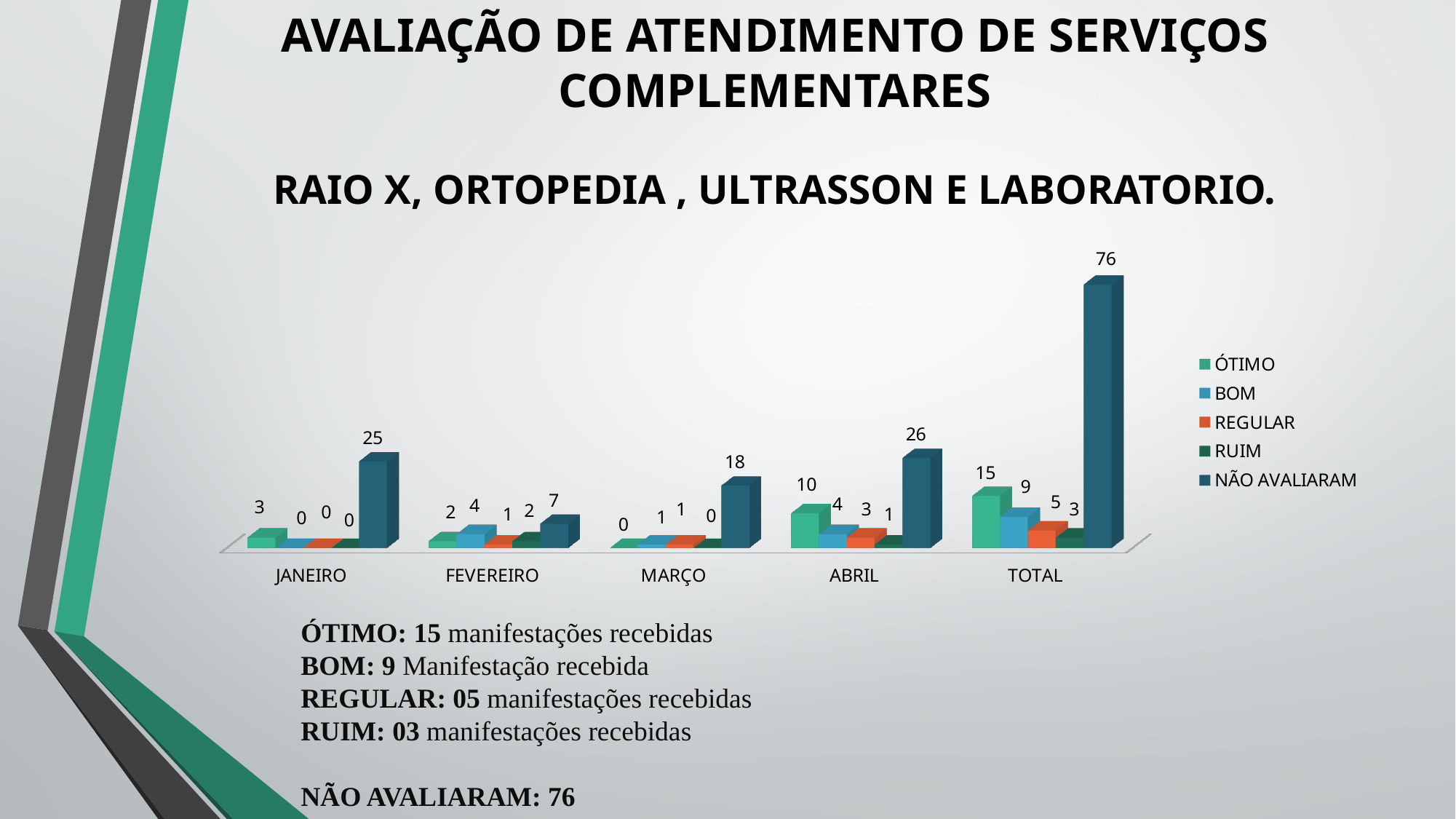
How many categories are shown along the x axis of the chart? 5 Which month has the highest NÃO AVALIARAM value (excluding TOTAL)? ABRIL What is the value of ÓTIMO for ABRIL? 10 How many series does the chart legend list? 5 Which series is shown in orange in the chart legend? REGULAR What is the value of BOM for FEVEREIRO? 4 What type of chart is shown on the slide? bar chart What is the value of NÃO AVALIARAM for JANEIRO? 25 What is the difference between the NÃO AVALIARAM values for ABRIL and JANEIRO? 1 What is the value of NÃO AVALIARAM for TOTAL? 76 Which month has the lowest NÃO AVALIARAM value? FEVEREIRO Which is larger, the ÓTIMO value for ABRIL or the ÓTIMO value for FEVEREIRO? ABRIL